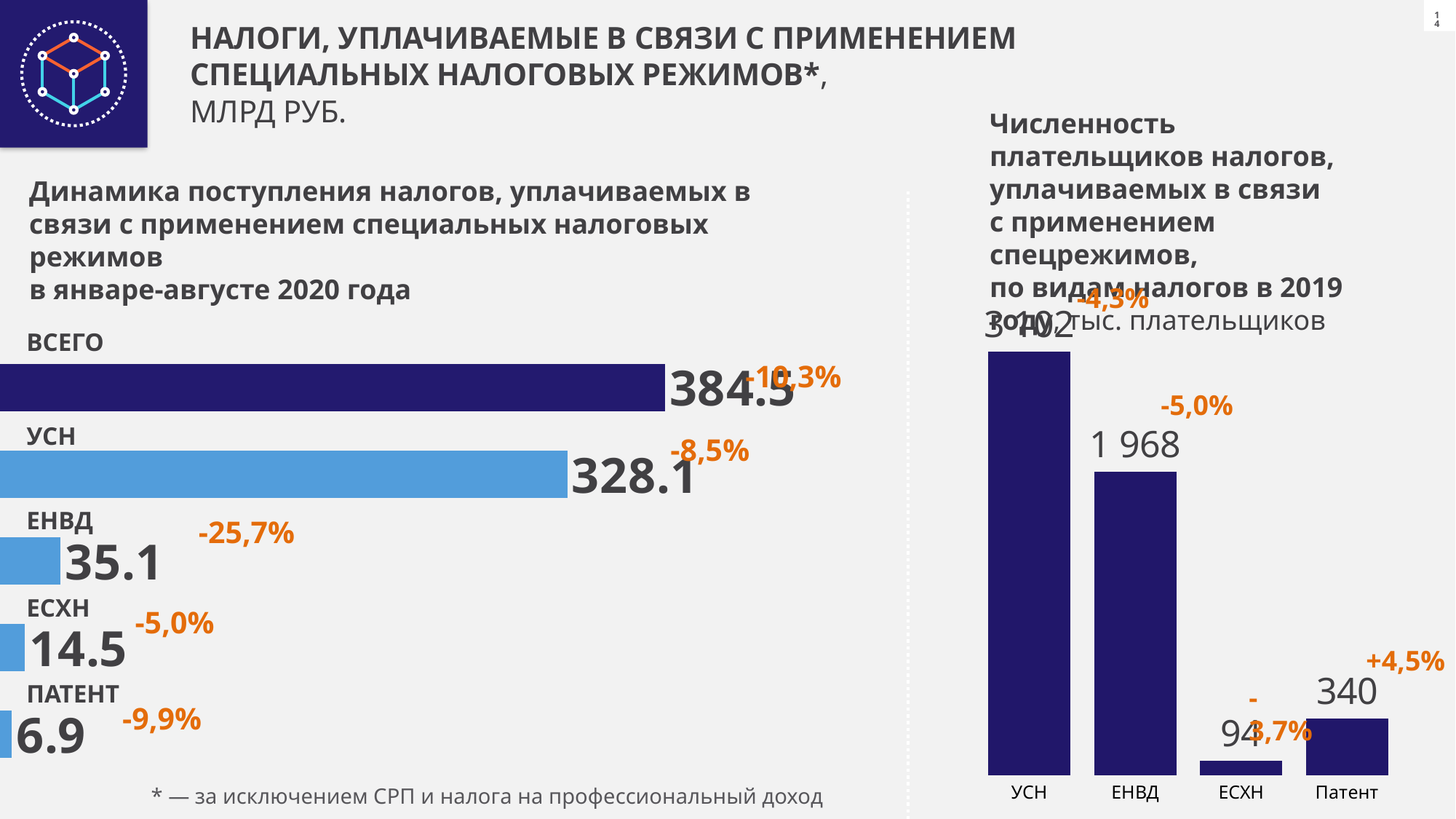
In the left chart (Динамика поступления налогов), which tax regime (excluding ВСЕГО) has the lowest value? ПАТЕНТ What kind of chart is the right chart (Численность плательщиков налогов)? bar chart In the left chart (Динамика поступления налогов), what is the value for ПАТЕНТ? 6.9 In the right chart (Численность плательщиков налогов), which category has the highest value? УСН In the left chart (Динамика поступления налогов), what is the value for УСН? 328.1 In the left chart (Динамика поступления налогов), what is the value for ЕНВД? 35.1 In the left chart (Динамика поступления налогов), what is the difference between the values for УСН and ЕНВД? 293.0 In the left chart (Динамика поступления налогов), what is the value for ЕСХН? 14.5 In the right chart (Численность плательщиков налогов), what is the value for Патент? 340 In the left chart (Динамика поступления налогов), which is larger, the value for ЕСХН or the value for ПАТЕНТ? ЕСХН In the right chart (Численность плательщиков налогов), what is the value for ЕНВД? 1 968 In the left chart (Динамика поступления налогов), what percentage change is shown for ЕНВД? -25,7%